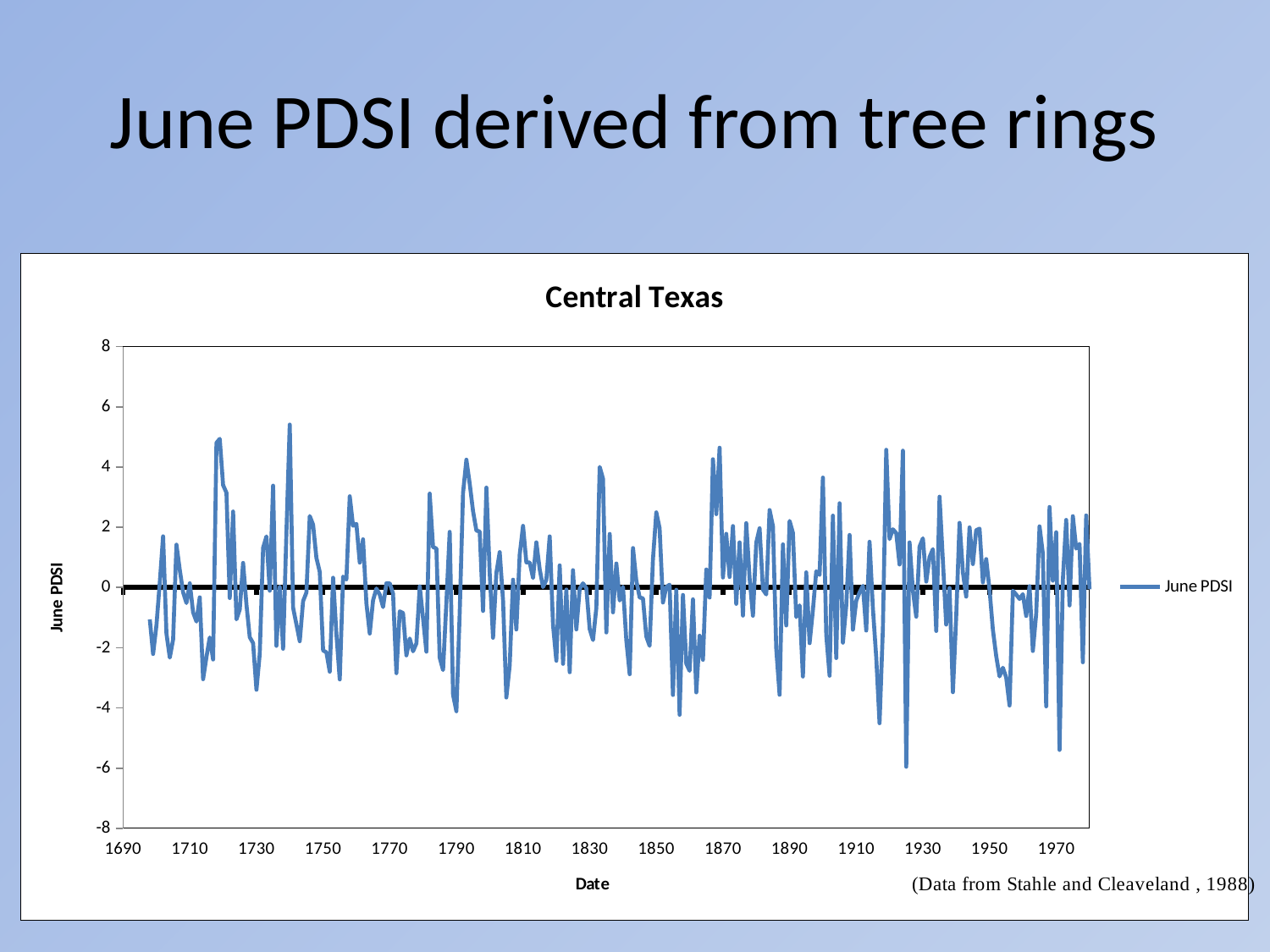
What is the title of the chart? Central Texas Is the June PDSI value at the peak around 1740 greater or less than 4? greater Is the highest June PDSI value on the chart greater or less than 4? greater What series name appears in the legend? June PDSI Is the highest June PDSI value on the chart greater or less than 6? less How many series does the legend list? 1 What kind of chart is shown on the slide? line chart